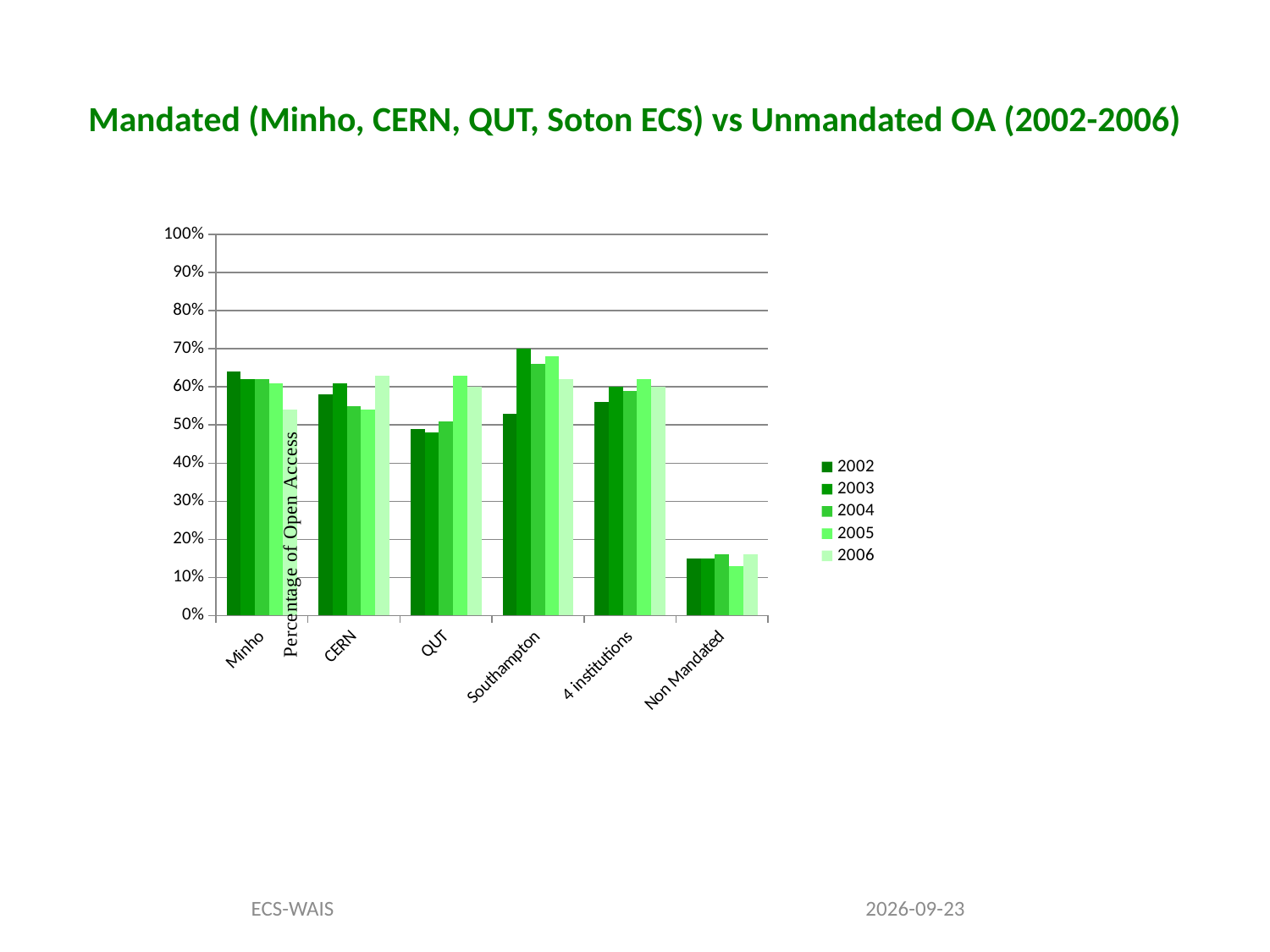
Is the value for Southampton in 2003 greater or less than 60%? greater How many categories are shown along the x axis? 6 Which is larger, the 2002 value for Minho or the 2002 value for Non Mandated? Minho Which is larger, the 2003 value for Southampton or the 2003 value for QUT? Southampton Which category has the lowest values across all years? Non Mandated Is the value for Non Mandated in 2002 greater or less than 20%? less Which category contains the tallest bar in the chart? Southampton What is the title of the vertical axis? Percentage of Open Access What kind of chart is shown on the slide? bar chart Do the values for Minho rise or fall from 2002 to 2006? fall How many series does the legend list? 5